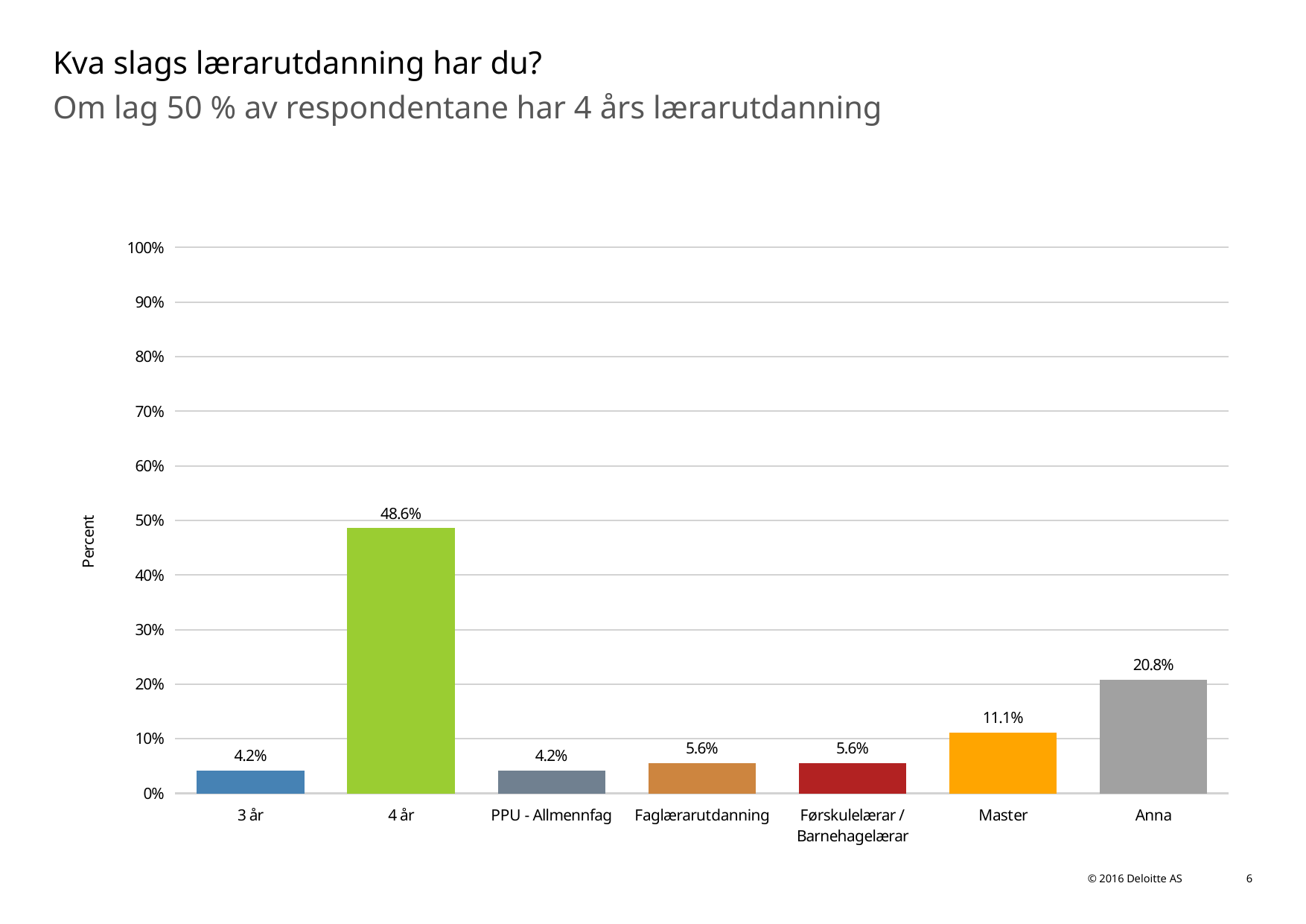
What is the difference between the values for 4 år and Anna? 27.8% Is the value for Anna greater or less than 30%? less What kind of chart is shown on the slide? bar chart What is the label of the y axis? Percent What is the value for Master? 11.1% How many categories are shown on the x axis? 7 What is the value for Faglærarutdanning? 5.6% Which category has the highest value? 4 år What is the value for Anna? 20.8% Which is larger, the value for Master or the value for PPU - Allmennfag? Master What is the difference between the values for Master and 3 år? 6.9% What is the value for 4 år? 48.6%